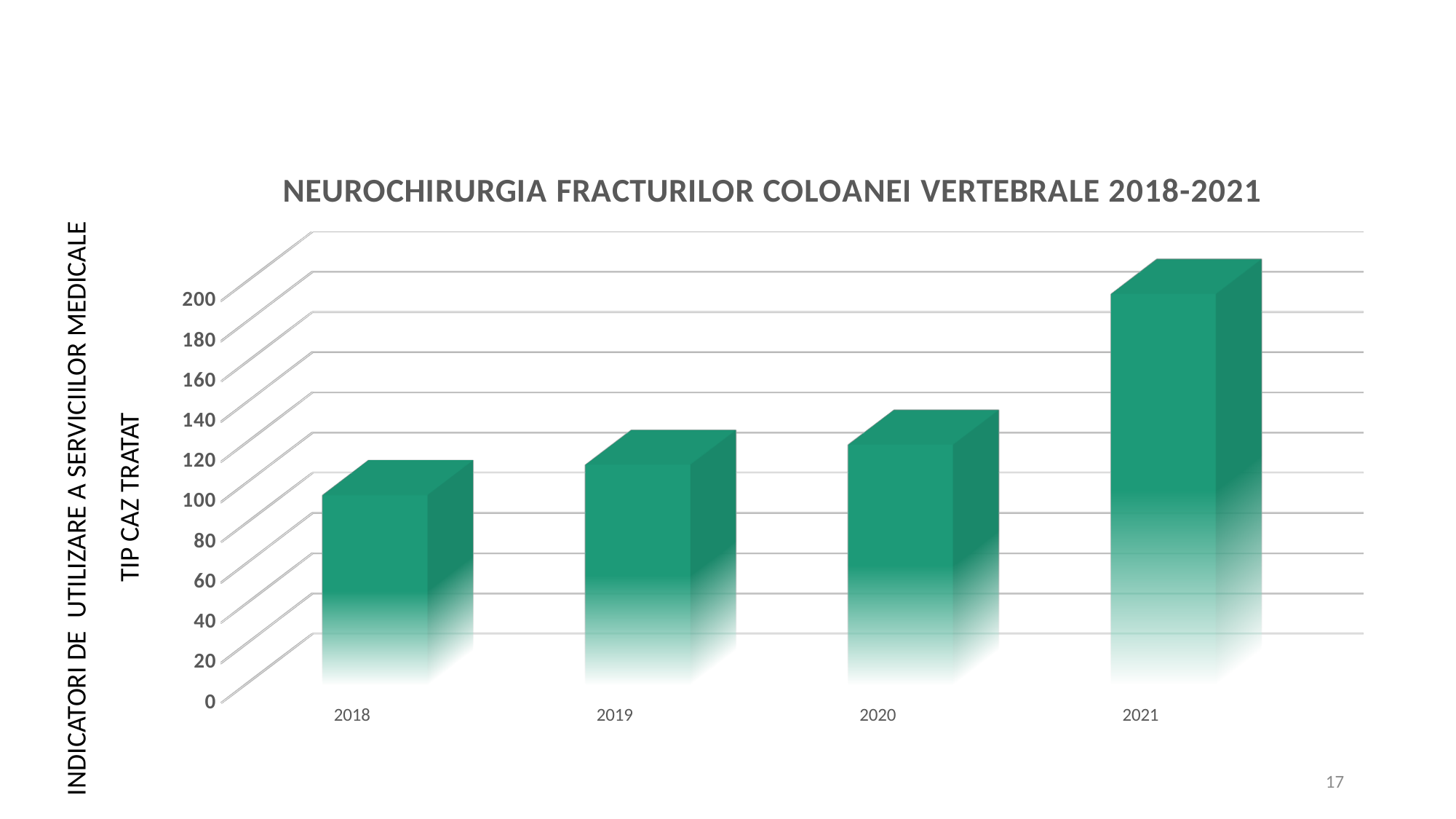
Which is larger, the value for 2021 or the value for 2019? 2021 Which year has the lowest bar? 2018 What colour are the bars in the chart? Green Is the value for 2020 greater or less than 100? greater How many years (categories) are plotted on the x axis? 4 Which year has the highest bar? 2021 What is the title of the chart? NEUROCHIRURGIA FRACTURILOR COLOANEI VERTEBRALE 2018-2021 Is the value for 2019 greater or less than 140? less Do the values rise or fall from 2018 to 2021? Rise What kind of chart is shown on the slide? Bar chart Is the value for 2021 greater or less than 180? greater Which is larger, the value for 2020 or the value for 2018? 2020